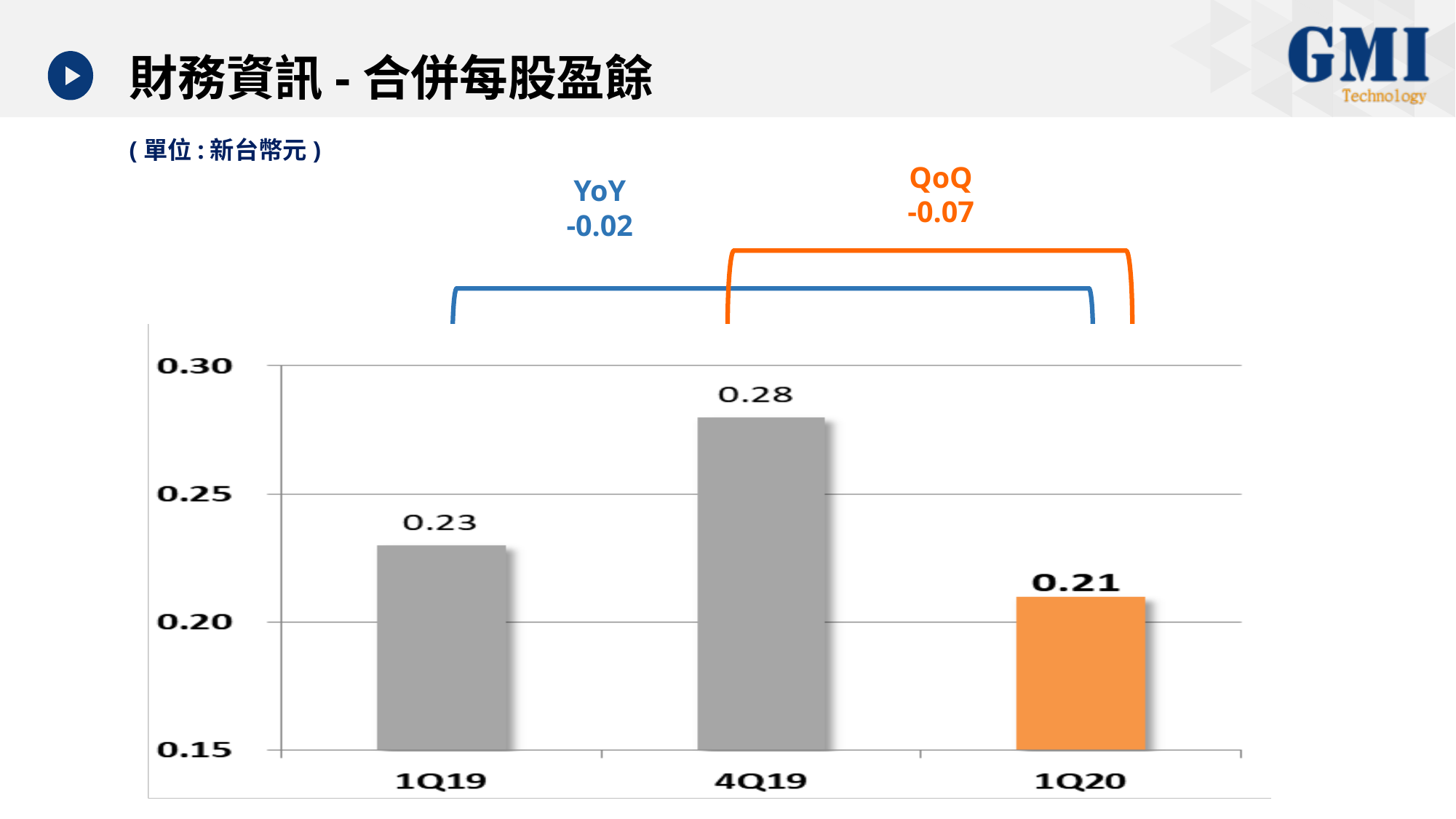
What is the difference between the EPS for 4Q19 and 1Q20? 0.07 What is the EPS value for 1Q20? 0.21 What is the EPS value for 4Q19? 0.28 What is the YoY change shown above the chart? -0.02 Is the value for 4Q19 greater or less than 0.25? greater What is the difference between the EPS for 1Q19 and 1Q20? 0.02 What is the EPS value for 1Q19? 0.23 How many quarters are shown in the chart? 3 Which is larger, the EPS for 1Q19 or 1Q20? 1Q19 Which quarter has the highest EPS? 4Q19 Which quarter has the lowest EPS? 1Q20 What kind of chart is shown on the slide? Bar chart